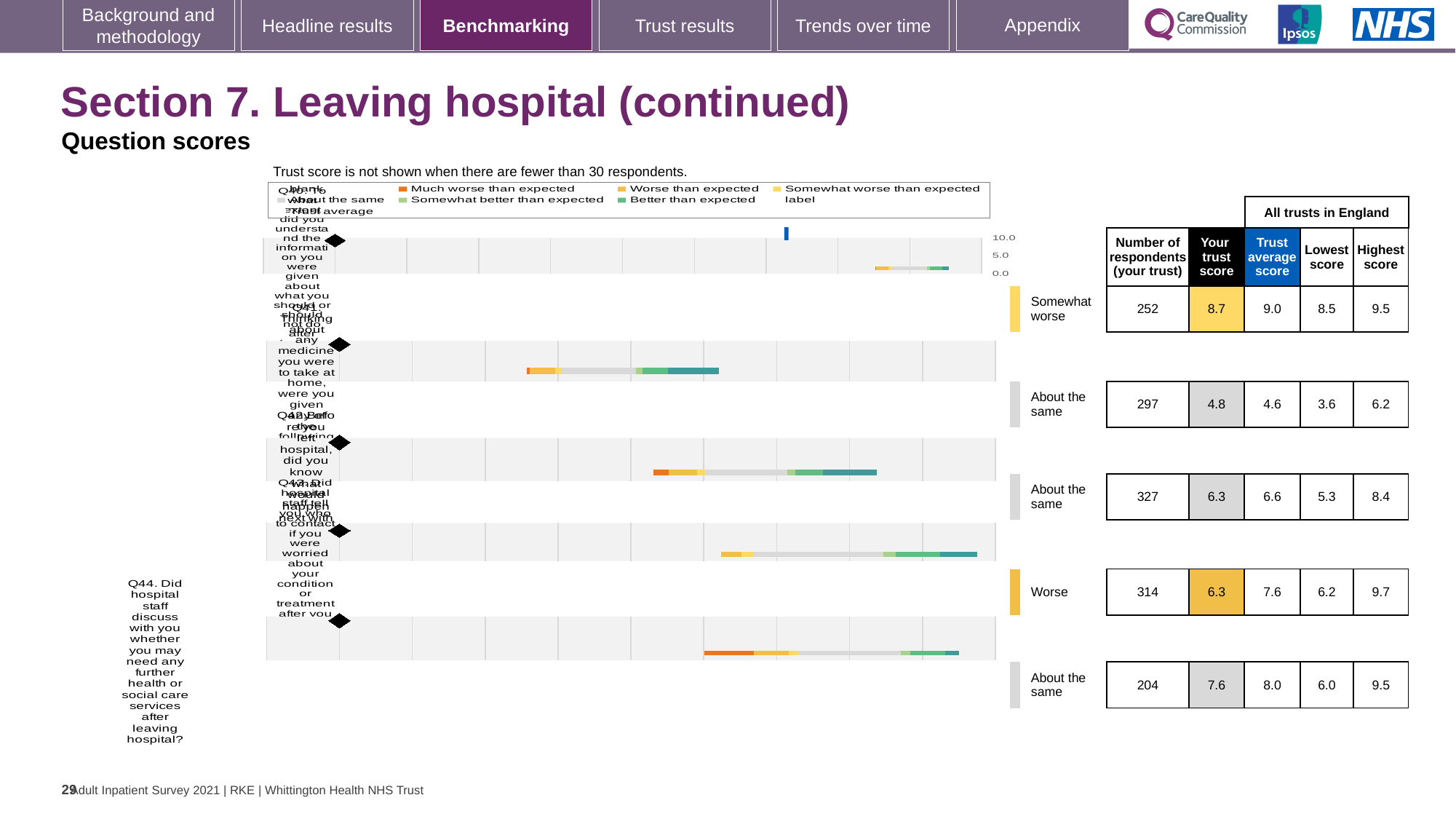
What is the maximum value shown on the chart's score axis? 10.0 In the second row (297 respondents), is your trust score higher or lower than the trust average score? higher What is the highest score across all trusts in England for Q44 (the last row)? 9.5 What is the highest number of respondents shown in the table? 327 What is the lowest score across all trusts in England for the question rated "Worse"? 6.2 What is your trust score for Q44 (the last row)? 7.6 What is the lowest number of respondents shown in the table? 204 How many respondents (your trust) are shown for the question rated "Worse"? 314 What is your trust score for the question rated "Somewhat worse" (the first row)? 8.7 What is the trust average score for the question rated "Worse"? 7.6 For the question rated "Worse", what is the difference between the trust average score and your trust score? 1.3 How many question rows are shown on the chart? 5